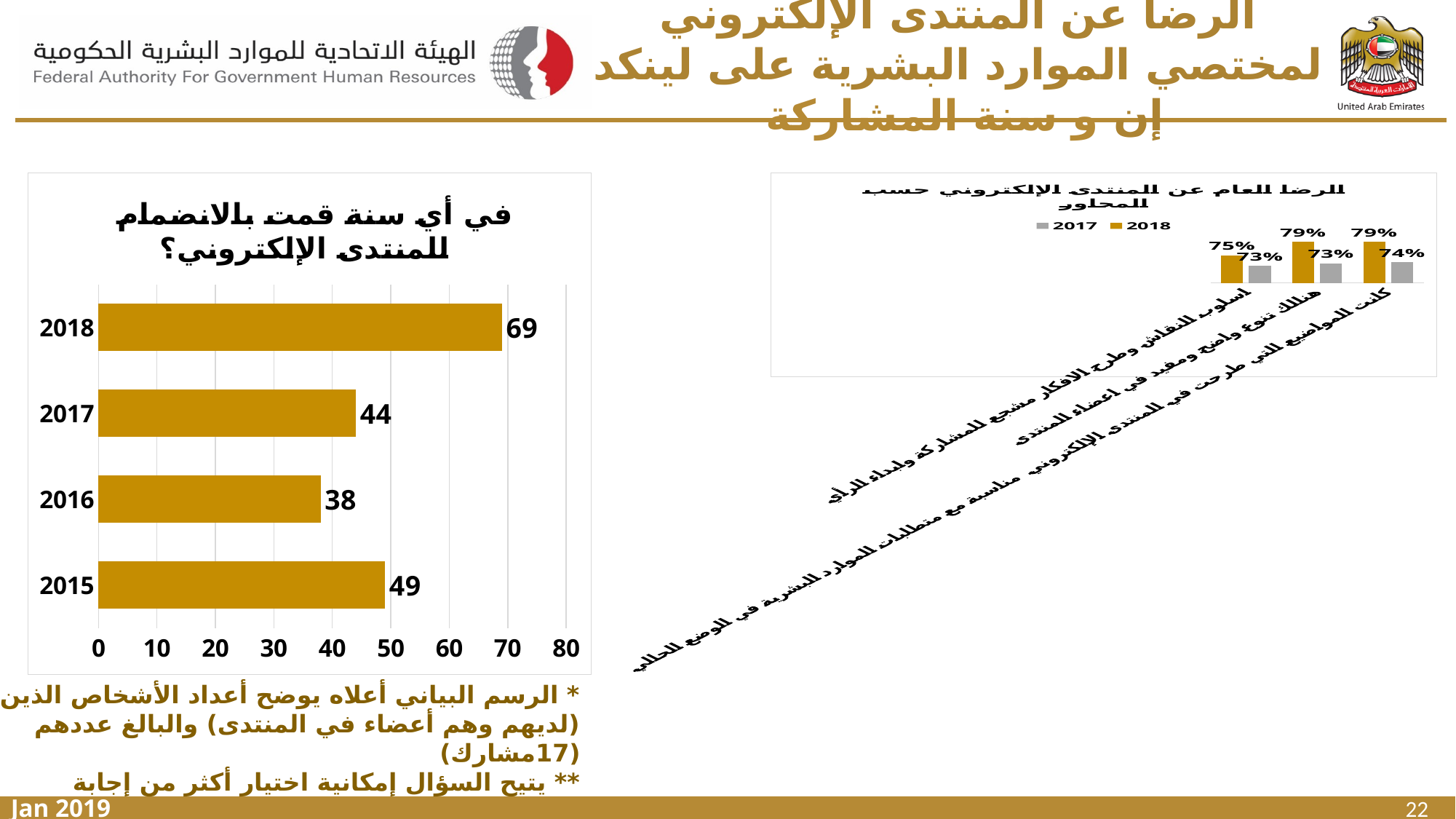
In the right chart 'الرضا العام عن المنتدى الإلكتروني حسب المحاور', what is the 2017 value for the rightmost category? 74% In the right chart 'الرضا العام عن المنتدى الإلكتروني حسب المحاور', how many series does the legend list? 2 In the left chart 'في أي سنة قمت بالانضمام للمنتدى الإلكتروني؟', which year has the highest value? 2018 In the left chart 'في أي سنة قمت بالانضمام للمنتدى الإلكتروني؟', what is the difference between the values for 2018 and 2017? 25 What type of chart is the left chart 'في أي سنة قمت بالانضمام للمنتدى الإلكتروني؟'? Bar chart In the left chart 'في أي سنة قمت بالانضمام للمنتدى الإلكتروني؟', what is the value for 2016? 38 In the right chart 'الرضا العام عن المنتدى الإلكتروني حسب المحاور', what is the 2018 value for the leftmost category? 75% In the left chart 'في أي سنة قمت بالانضمام للمنتدى الإلكتروني؟', what is the value for 2018? 69 In the left chart 'في أي سنة قمت بالانضمام للمنتدى الإلكتروني؟', which year has the lowest value? 2016 In the left chart 'في أي سنة قمت بالانضمام للمنتدى الإلكتروني؟', which is larger, the value for 2015 or the value for 2017? 2015 In the right chart 'الرضا العام عن المنتدى الإلكتروني حسب المحاور', which colour represents the 2018 series? Gold In the left chart 'في أي سنة قمت بالانضمام للمنتدى الإلكتروني؟', how many years are shown? 4